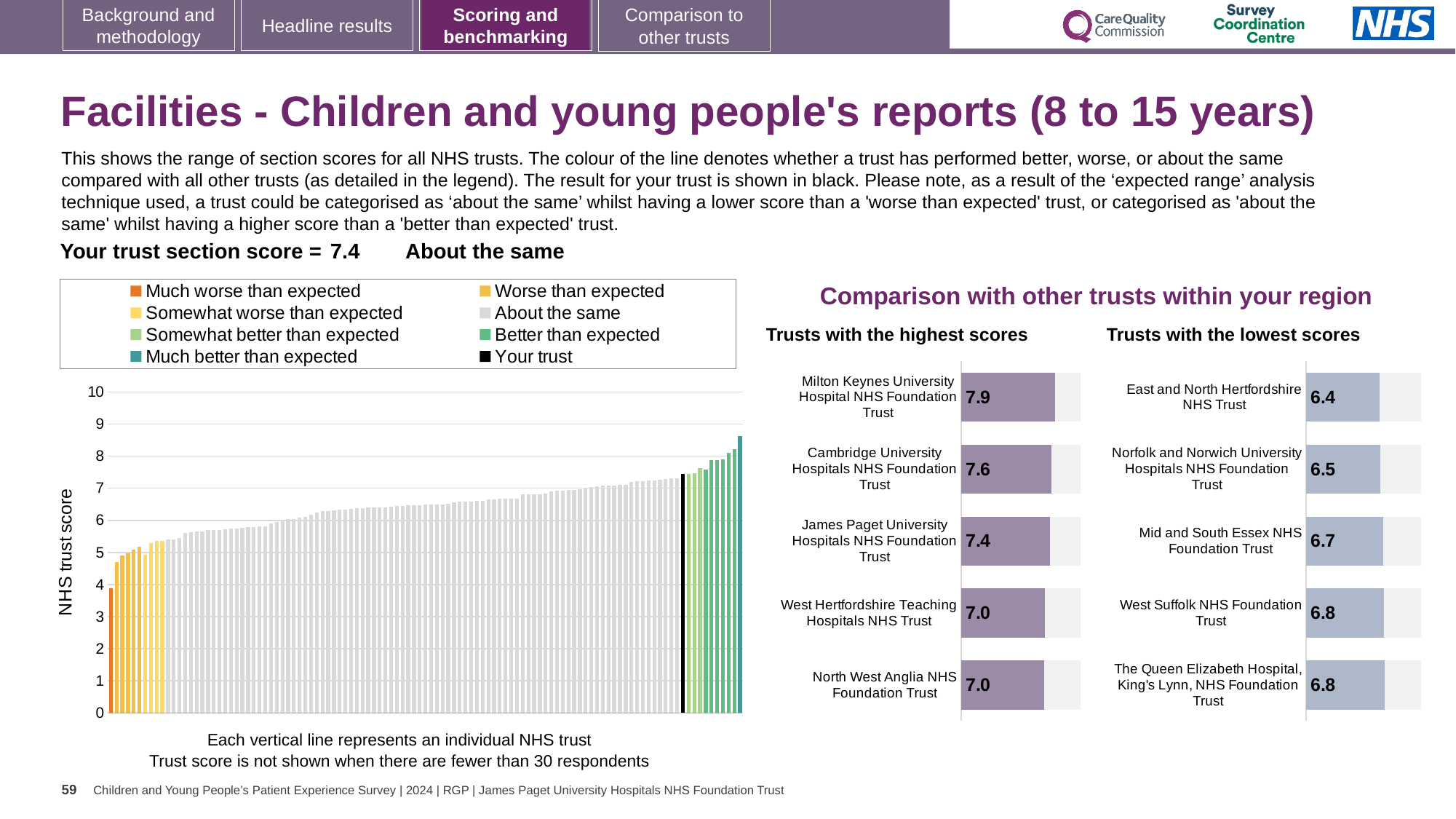
How many entries does the legend of the main 'NHS trust score' chart list? 8 In the 'Trusts with the highest scores' chart, what is the difference between the scores of Milton Keynes University Hospital NHS Foundation Trust and James Paget University Hospitals NHS Foundation Trust? 0.5 In the 'Trusts with the lowest scores' chart, what is the score for Norfolk and Norwich University Hospitals NHS Foundation Trust? 6.5 How many trusts are shown in the 'Trusts with the highest scores' chart? 5 Which is larger: the score for Cambridge University Hospitals NHS Foundation Trust in the highest scores chart, or the score for Mid and South Essex NHS Foundation Trust in the lowest scores chart? Cambridge University Hospitals NHS Foundation Trust In the main 'NHS trust score' chart, is the value of the leftmost (orange) bar greater or less than 5? less In the 'Trusts with the highest scores' chart, what is the score for Milton Keynes University Hospital NHS Foundation Trust? 7.9 What kind of chart is the main chart on the left showing NHS trust scores? Bar chart In the main 'NHS trust score' chart, do the bar values rise or fall from left to right? Rise In the 'Trusts with the lowest scores' chart, which trust has the lowest score? East and North Hertfordshire NHS Trust In the 'Trusts with the highest scores' chart, which trust has the highest score? Milton Keynes University Hospital NHS Foundation Trust In the 'Trusts with the lowest scores' chart, what is the difference between the scores of West Suffolk NHS Foundation Trust and East and North Hertfordshire NHS Trust? 0.4